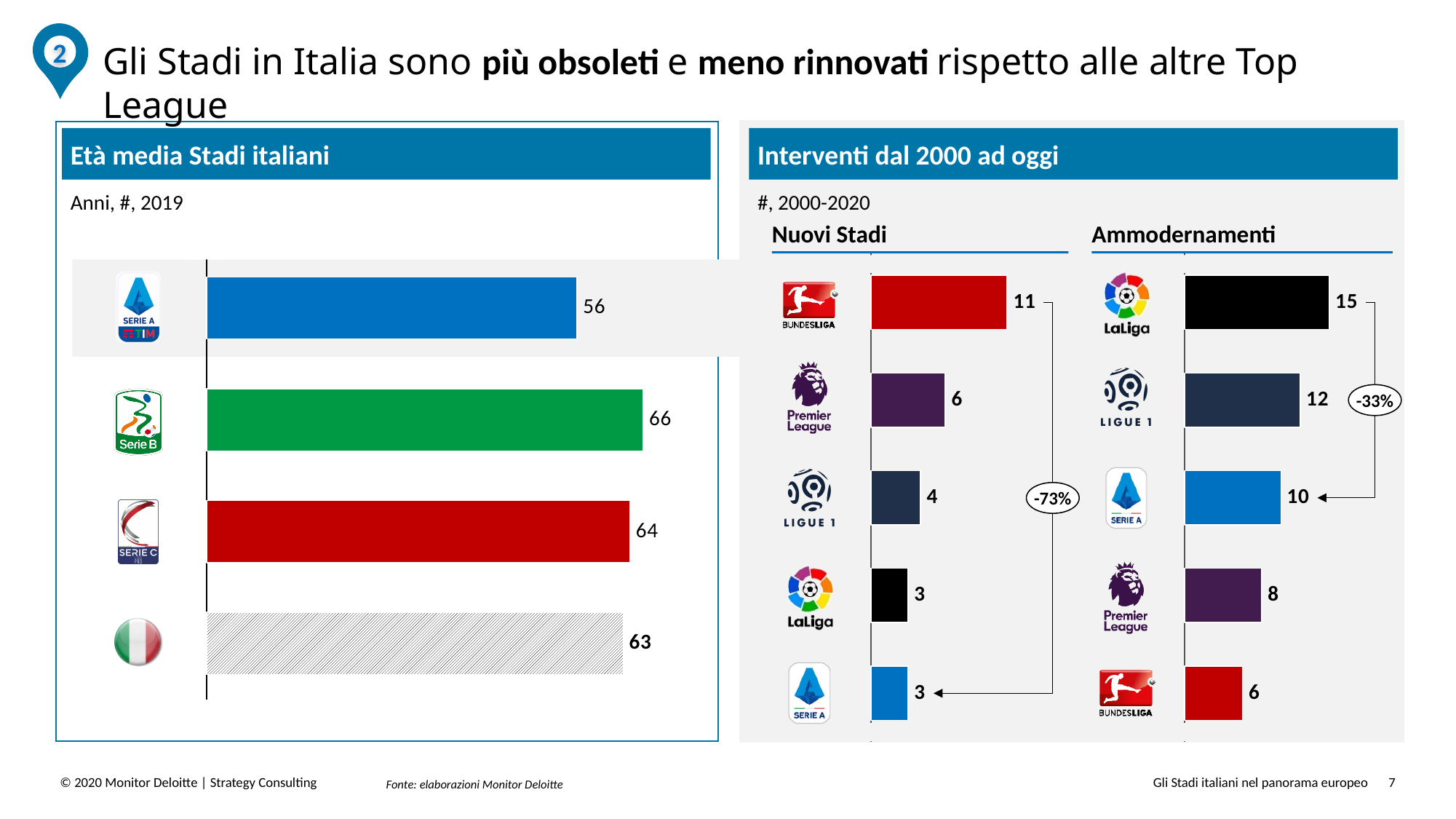
In the 'Nuovi Stadi' chart, what is the value for Bundesliga? 11 What kind of chart is the 'Età media Stadi italiani' chart? Bar chart In the 'Nuovi Stadi' chart, which league has the highest value? Bundesliga In the 'Ammodernamenti' chart, which is larger: the value for Ligue 1 or the value for Premier League? Ligue 1 In the 'Ammodernamenti' chart, which league has the lowest value? Bundesliga In the 'Età media Stadi italiani' chart, what is the difference between the Serie B and Serie A values? 10 In the 'Nuovi Stadi' chart, what is the value for Premier League? 6 In the 'Ammodernamenti' chart, what is the value for LaLiga? 15 In the 'Età media Stadi italiani' chart, how many bars are plotted? 4 In the 'Età media Stadi italiani' chart, what is the value for Serie A? 56 In the 'Età media Stadi italiani' chart, which category has the highest value? Serie B In the 'Ammodernamenti' chart, what is the difference between the LaLiga and Serie A values? 5